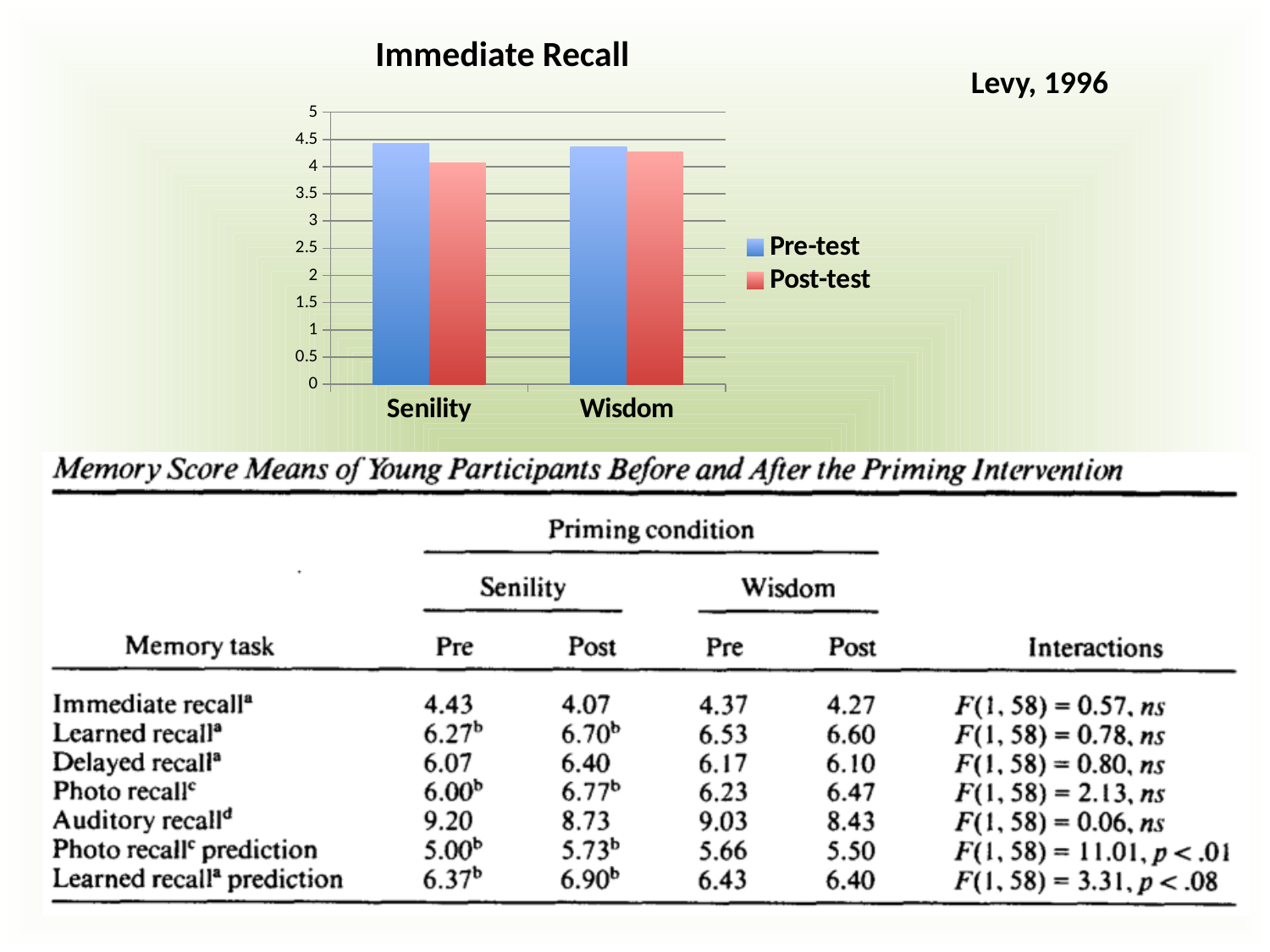
In the Immediate Recall chart, is the Post-test value for Wisdom greater or less than 4? greater In the Immediate Recall chart, is the Pre-test value for Wisdom greater or less than 4.5? less What type of chart is shown under the title "Immediate Recall"? bar chart How many series does the legend of the Immediate Recall chart list? 2 In the Immediate Recall chart, is the Pre-test bar for Senility higher or lower than the Post-test bar for Senility? higher According to the table, what is the Immediate recall Post score for the Wisdom priming condition? 4.27 In the Immediate Recall chart, which bar is the lowest? Senility Post-test How many categories are shown on the x axis of the Immediate Recall chart? 2 According to the table, what is the Immediate recall Pre score for the Senility priming condition? 4.43 In the Immediate Recall chart, is the Pre-test value for Senility greater or less than 4? greater In the Immediate Recall chart, which is larger: the Post-test value for Senility or the Post-test value for Wisdom? Wisdom Using the Immediate recall values in the table, what is the difference between the Senility Pre score and the Senility Post score? 0.36